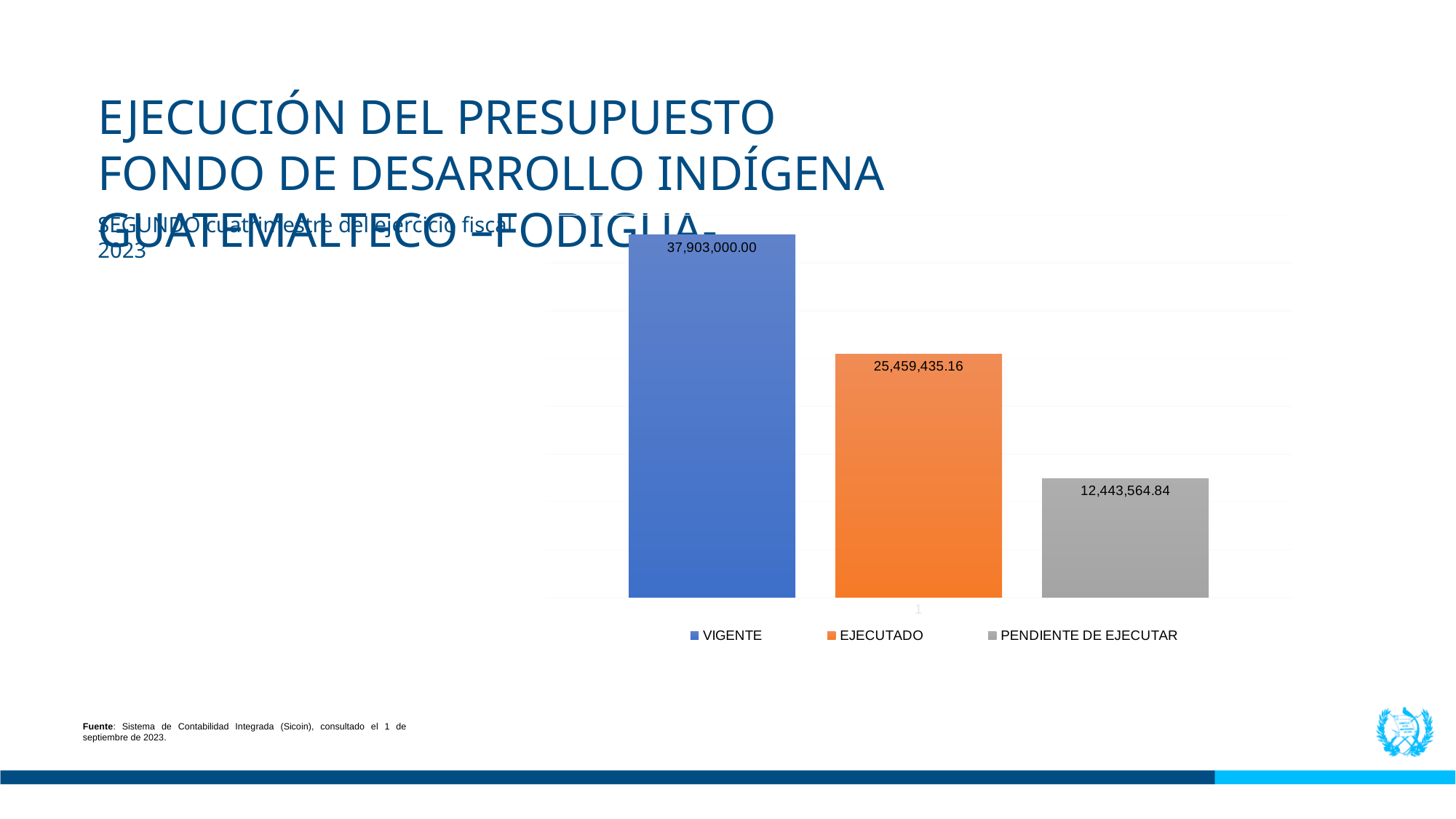
What is the difference between VIGENTE and EJECUTADO? 12,443,564.84 What is the value for PENDIENTE DE EJECUTAR? 12,443,564.84 Which legend entry is shown in grey? PENDIENTE DE EJECUTAR What kind of chart is shown on the slide? Bar chart How many series does the legend list? 3 What is the value for EJECUTADO? 25,459,435.16 What colour is the bar for EJECUTADO? Orange Which series has the lowest value? PENDIENTE DE EJECUTAR What is the difference between EJECUTADO and PENDIENTE DE EJECUTAR? 13,015,870.32 What is the value for VIGENTE? 37,903,000.00 Which is larger, EJECUTADO or PENDIENTE DE EJECUTAR? EJECUTADO Which series has the highest value? VIGENTE